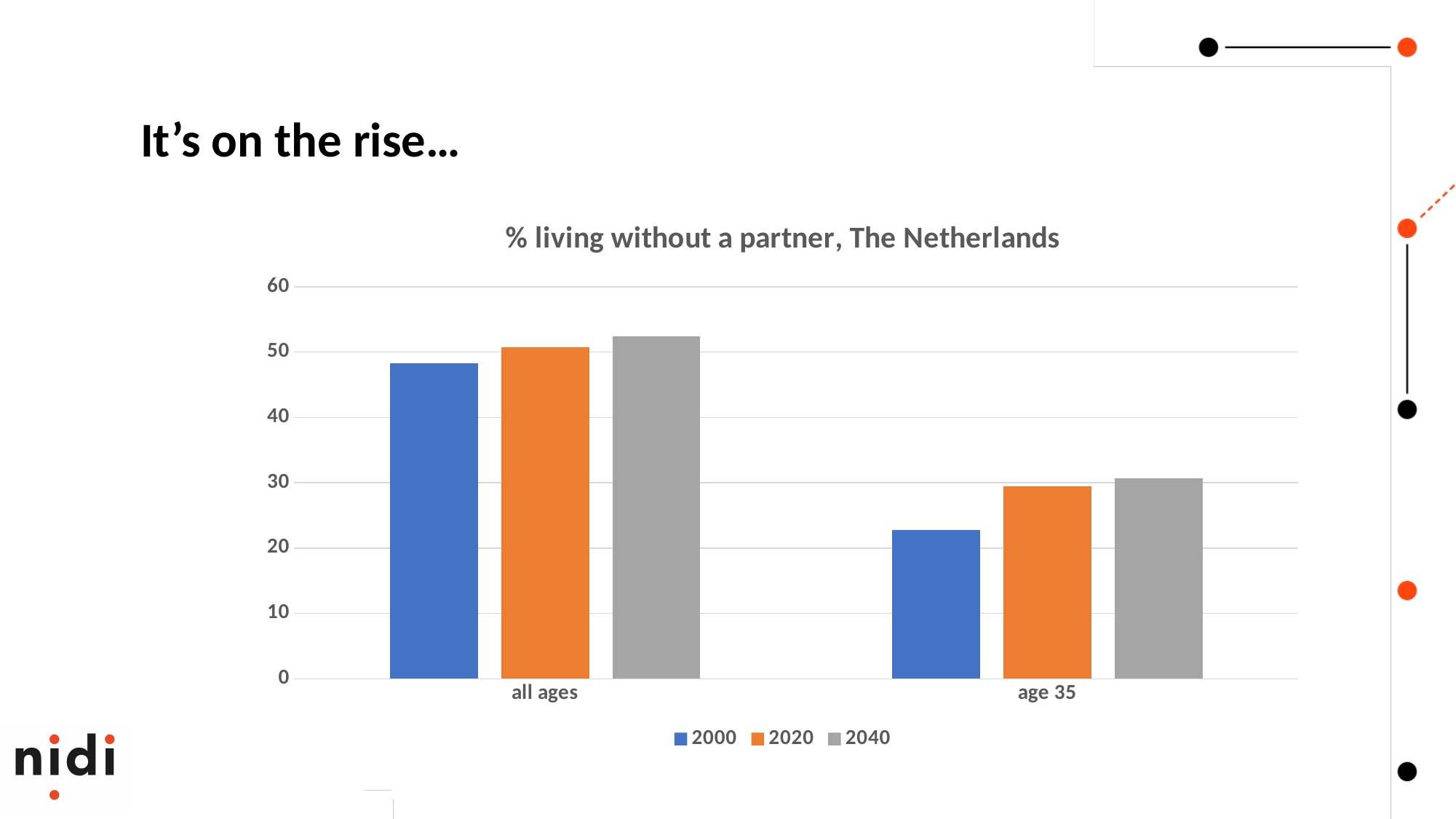
Which series has the lowest value in the 'age 35' category? 2000 What kind of chart is shown on the slide? bar chart How many categories are shown on the x axis? 2 Is the value for 2000 in the 'age 35' category greater or less than 30? less Is the value for 2000 in the 'all ages' category greater or less than 40? greater What is the title of the chart? % living without a partner, The Netherlands In the 'all ages' category, which is larger: the value for 2000 or the value for 2040? 2040 How many series does the legend list? 3 In the 'age 35' category, which is larger: the value for 2000 or the value for 2020? 2020 Is the value for 2000 in the 'age 35' category greater or less than 20? greater Which series is shown in orange? 2020